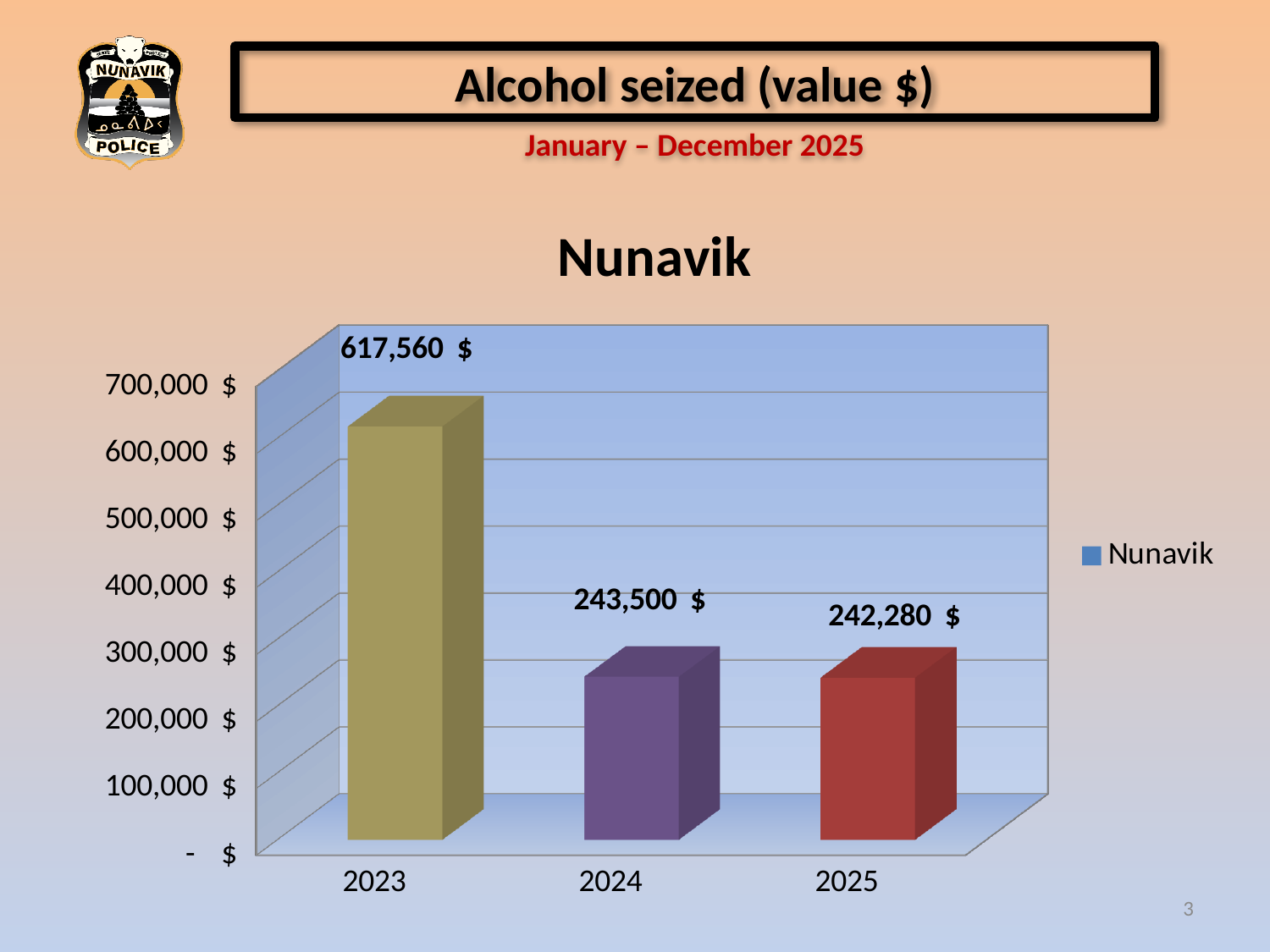
What is the title of the chart? Nunavik Which year has the highest value of alcohol seized? 2023 What kind of chart is shown on the slide? bar chart What is the difference between the 2023 and 2024 values? 374,060 $ What is the value of alcohol seized in 2023? 617,560 $ What is the value of alcohol seized in 2024? 243,500 $ What is the difference between the 2024 and 2025 values? 1,220 $ Which year has the lowest value of alcohol seized? 2025 Is the value for 2023 greater or less than 600,000 $? greater What is the value of alcohol seized in 2025? 242,280 $ How many years are shown on the chart? 3 Which is larger, the value for 2023 or the value for 2025? 2023